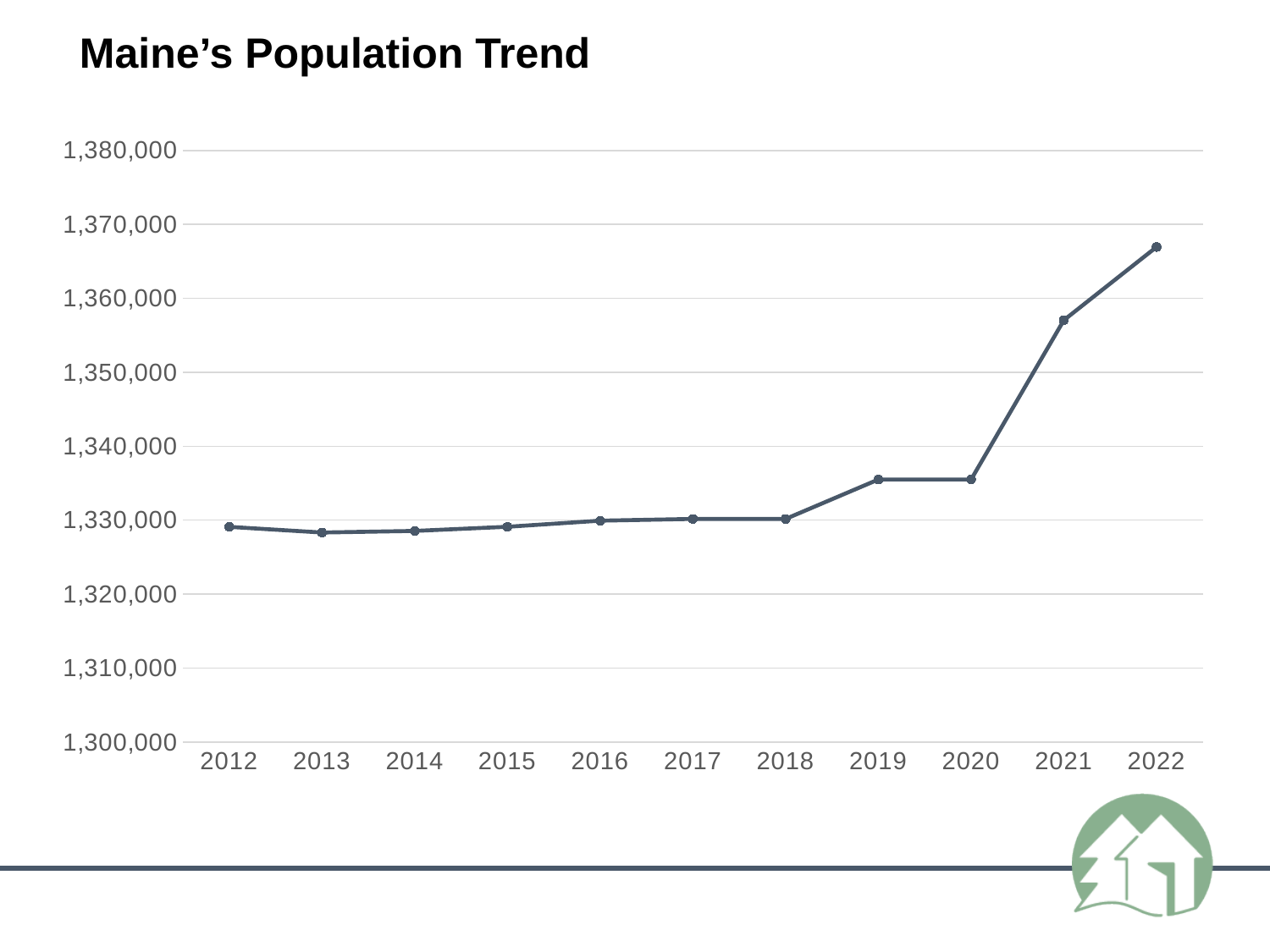
Is the value for 2021 greater or less than 1,350,000? greater Is the value for 2019 greater or less than 1,340,000? less Is the value for 2022 greater or less than 1,360,000? greater How many years are plotted on the x axis? 11 What is the title of the chart? Maine's Population Trend Which is larger, the value for 2019 or the value for 2021? 2021 Which year has the highest population value? 2022 What kind of chart is shown on the slide? line chart Does the population generally rise or fall from 2012 to 2022? rise Which is larger, the value for 2012 or the value for 2022? 2022